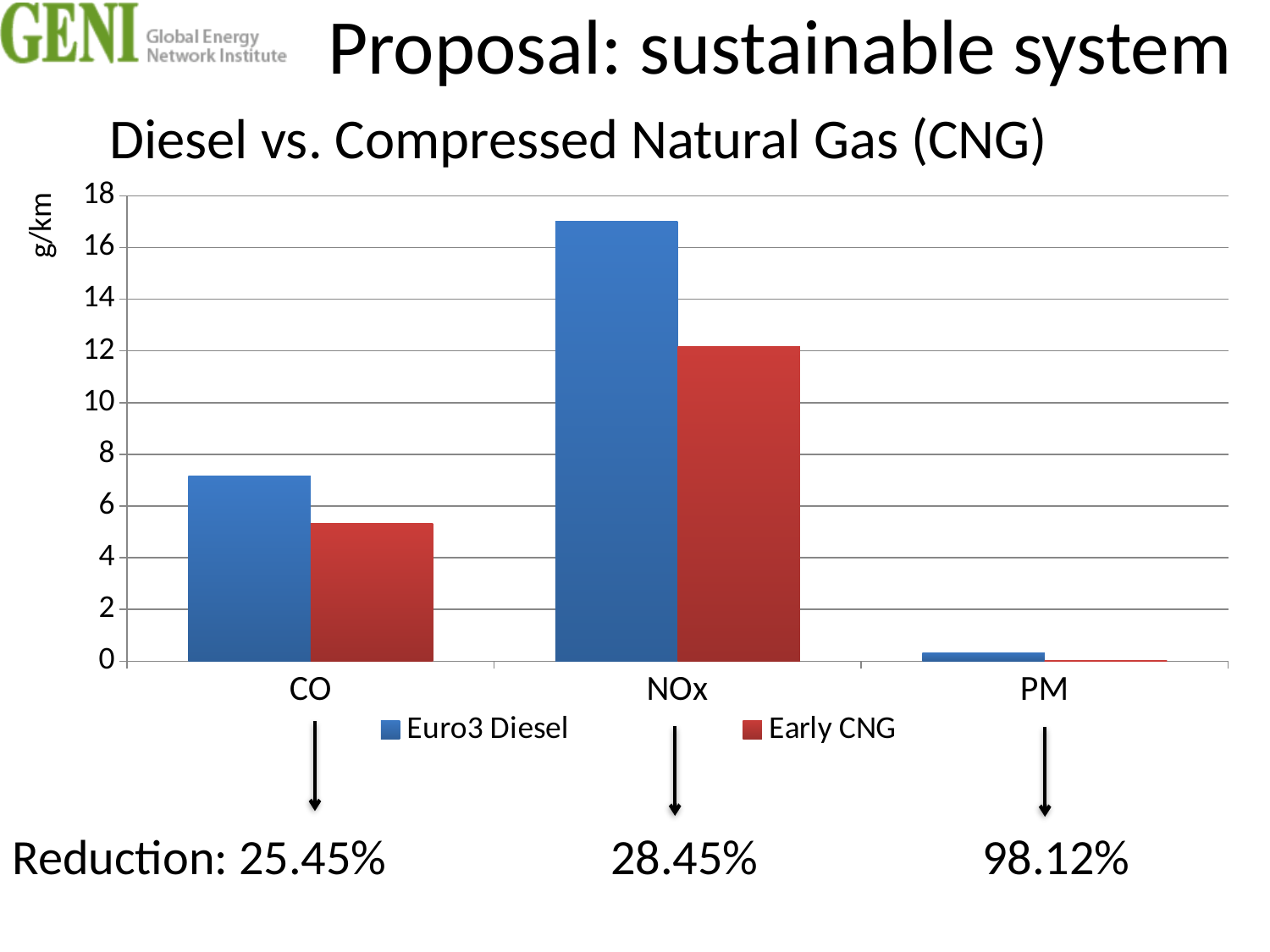
How many series does the legend list? 2 What kind of chart is shown on the slide? bar chart Which category has the highest Euro3 Diesel value? NOx What unit is shown on the y axis of the chart? g/km Is the Euro3 Diesel value for NOx greater or less than 16? greater How many categories are shown on the x axis? 3 For CO, which series has the larger value, Euro3 Diesel or Early CNG? Euro3 Diesel What reduction percentage is shown below the PM category? 98.12% Is the Early CNG value for NOx greater or less than 10? greater Is the Early CNG value for CO greater or less than 6? less Which category has the lowest Early CNG value? PM